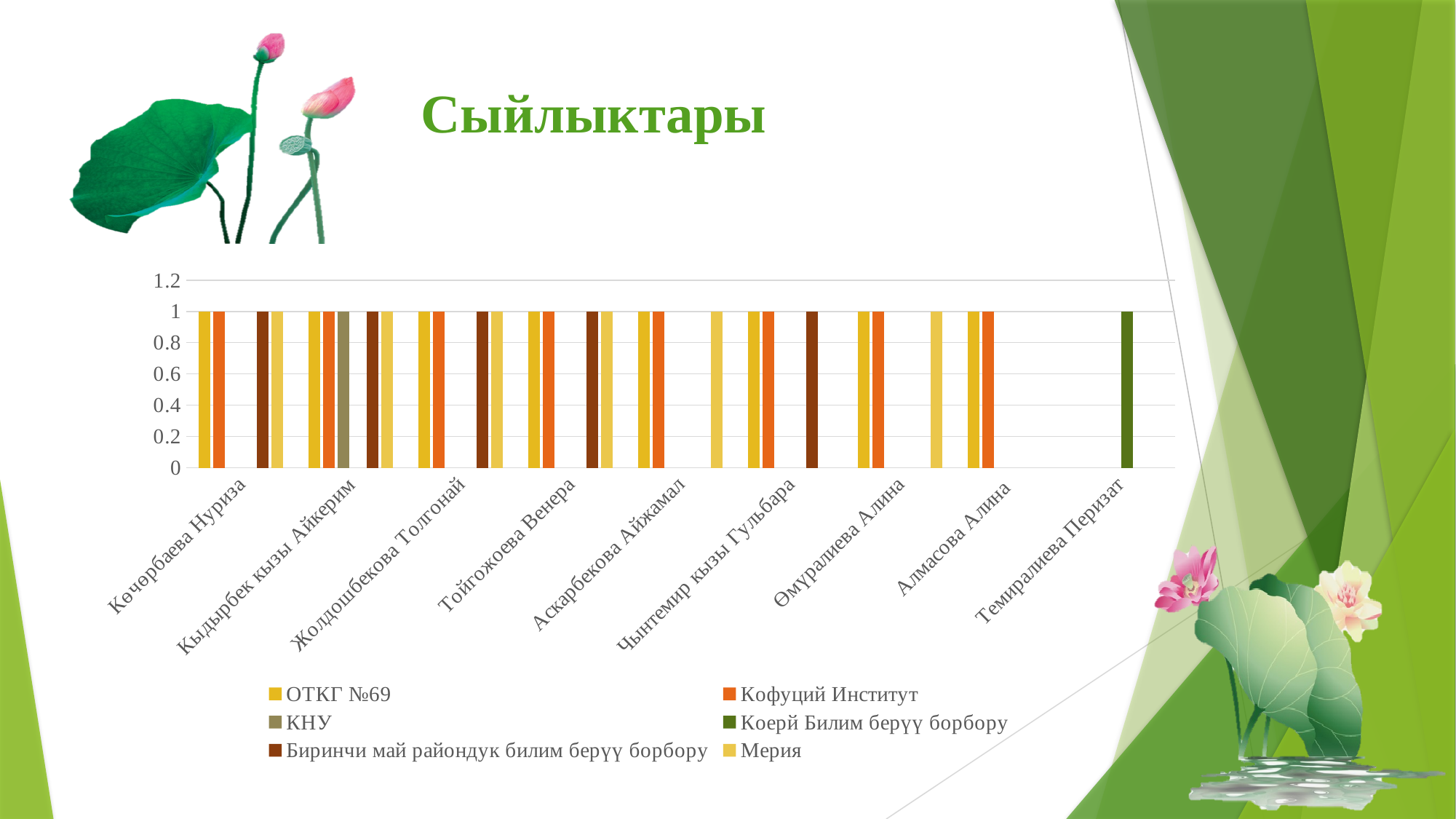
Is the value of the ОТКГ №69 bar for Көчөрбаева Нуриза greater or less than 1.2? less What is the title of the slide containing the chart? Сыйлыктары What is the highest value shown on the vertical axis? 1.2 Is the value of the Кофуций Институт bar for Көчөрбаева Нуриза greater or less than 0.8? greater What kind of chart is shown on the slide? bar chart How many series does the legend list? 6 Is the value of the Коерй Билим берүү борбору bar for Темиралиева Перизат greater or less than 0.6? greater What is the value of the Коерй Билим берүү борбору bar for Темиралиева Перизат? 1 Which series is shown in dark green in the legend? Коерй Билим берүү борбору What is the difference between the ОТКГ №69 bar and the Кофуций Институт bar for Көчөрбаева Нуриза? 0 What is the value of the ОТКГ №69 bar for Көчөрбаева Нуриза? 1